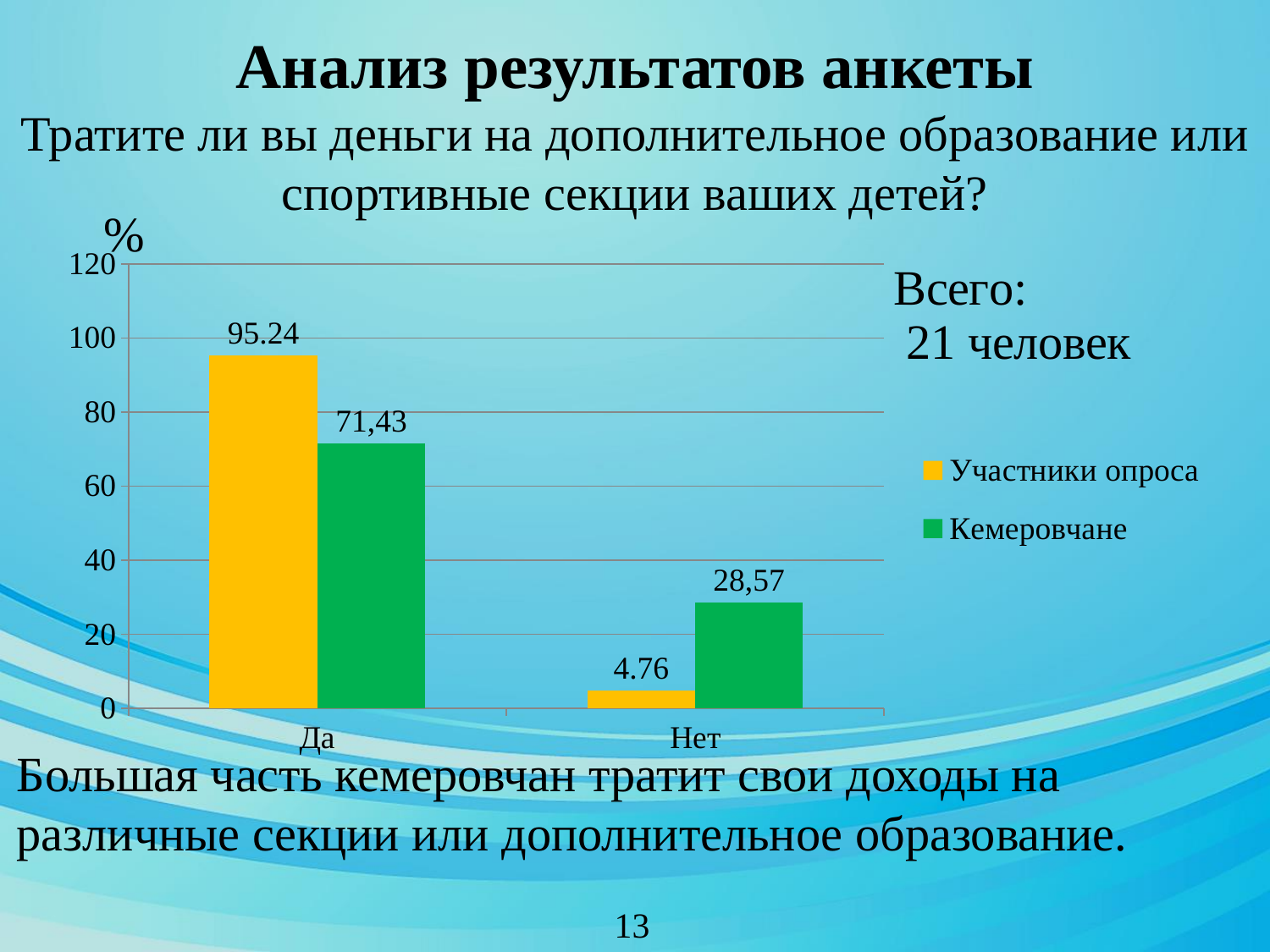
In the Нет category, which series has the larger value: Участники опроса or Кемеровчане? Кемеровчане How many categories are shown on the x axis? 2 What is the difference between the Участники опроса values for Да and Нет? 90.48 What kind of chart is shown on the slide? Bar chart What is the value for Кемеровчане in the Да category? 71,43 What is the value for Кемеровчане in the Нет category? 28,57 What is the value for Участники опроса in the Нет category? 4.76 Which bar has the lowest value on the chart? Участники опроса, Нет What is the difference between the Кемеровчане values for Да and Нет? 42,86 How many series does the legend list? 2 Which bar has the highest value on the chart? Участники опроса, Да What is the value for Участники опроса in the Да category? 95.24